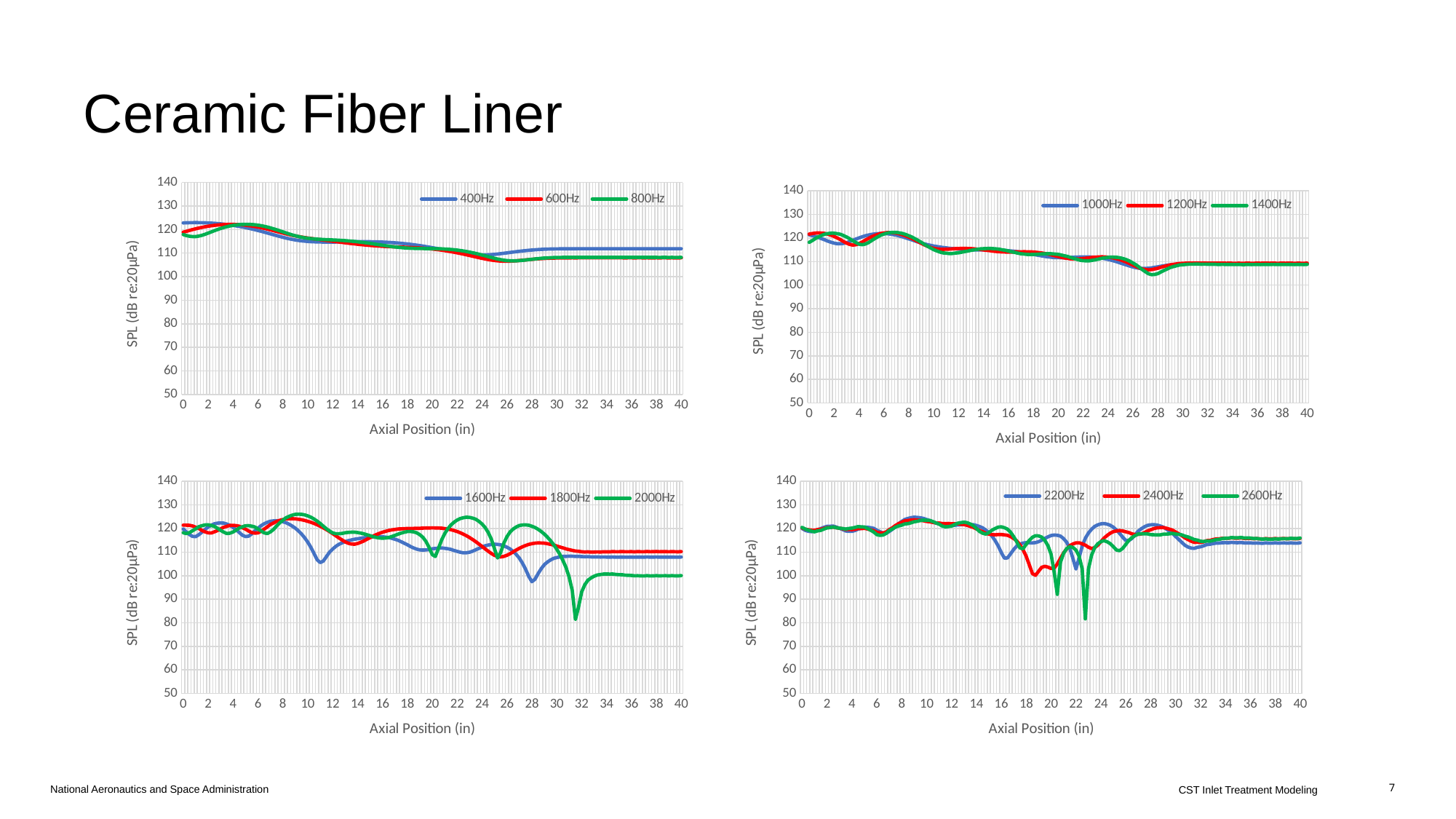
In the top-left chart, do the SPL values generally rise or fall as axial position increases from 0 to 40? Fall What kind of chart is the top-left chart with the 400Hz, 600Hz and 800Hz series? Line chart Which series are listed in the legend of the bottom-left chart? 1600Hz, 1800Hz, 2000Hz In the bottom-left chart, is the value for 2000Hz at axial position 40 greater or less than 110? less In the top-right chart, is the value for 1400Hz at axial position 28 greater or less than 110? less In the bottom-left chart, which series reaches the lowest SPL value? 2000Hz How many series does the legend of the top-right chart list? 3 In the bottom-right chart, which series reaches the lowest SPL value? 2600Hz In the bottom-right chart, is the value for 2400Hz at axial position 18 greater or less than 110? less How many charts are shown on the slide? 4